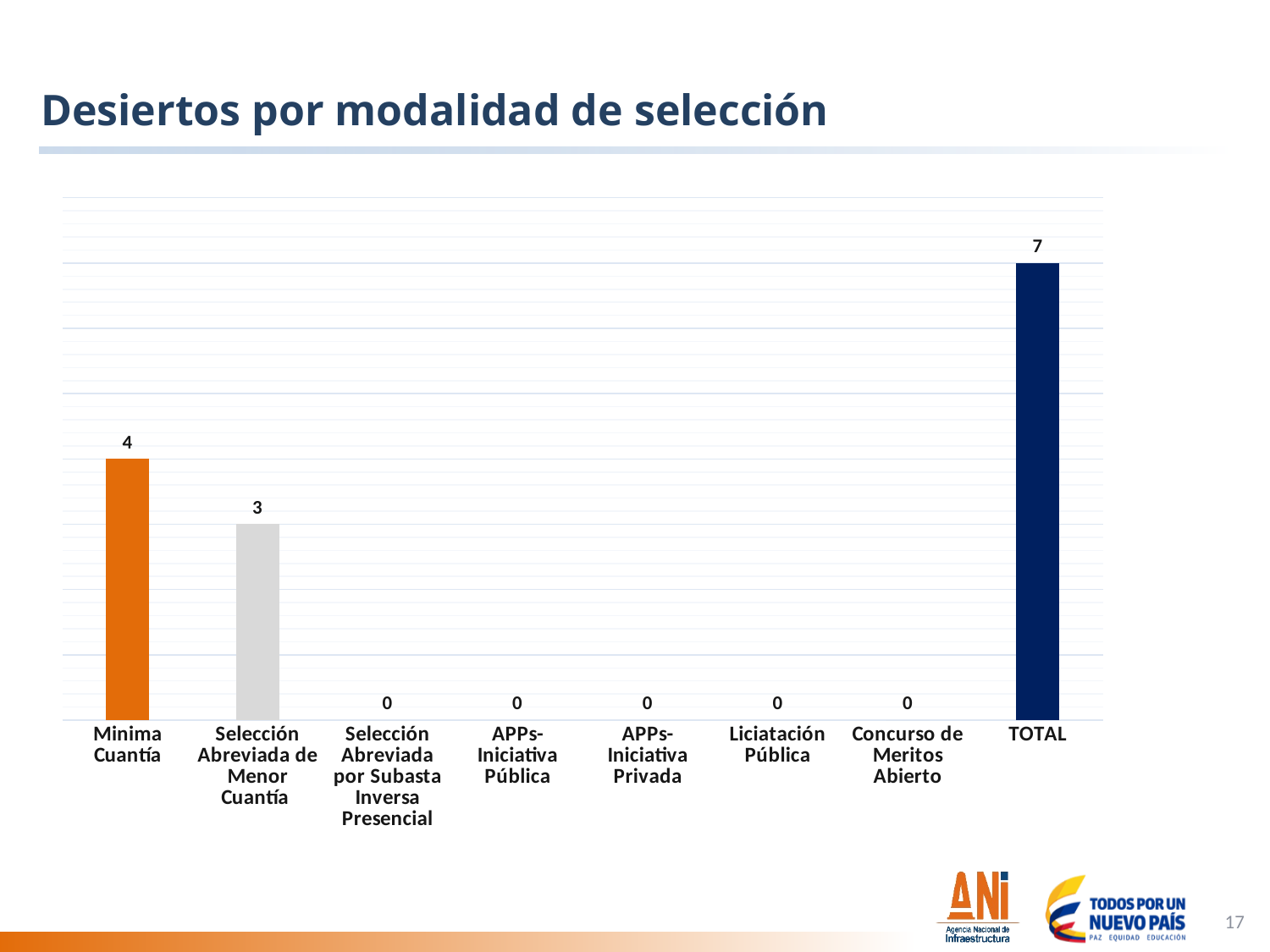
What is the title of the slide? Desiertos por modalidad de selección Which is larger, the value for Minima Cuantía or the value for Selección Abreviada de Menor Cuantía? Minima Cuantía What is the value for Selección Abreviada de Menor Cuantía? 3 What is the value for Minima Cuantía? 4 Which category has the highest value? TOTAL What kind of chart is shown on the slide? Bar chart How many categories have a value of 0? 5 What is the value for TOTAL? 7 How many categories are shown on the x axis? 8 What is the difference between the values for Minima Cuantía and Selección Abreviada de Menor Cuantía? 1 What is the value for Licitación Pública? 0 Excluding TOTAL, which selection modality has the highest value? Minima Cuantía